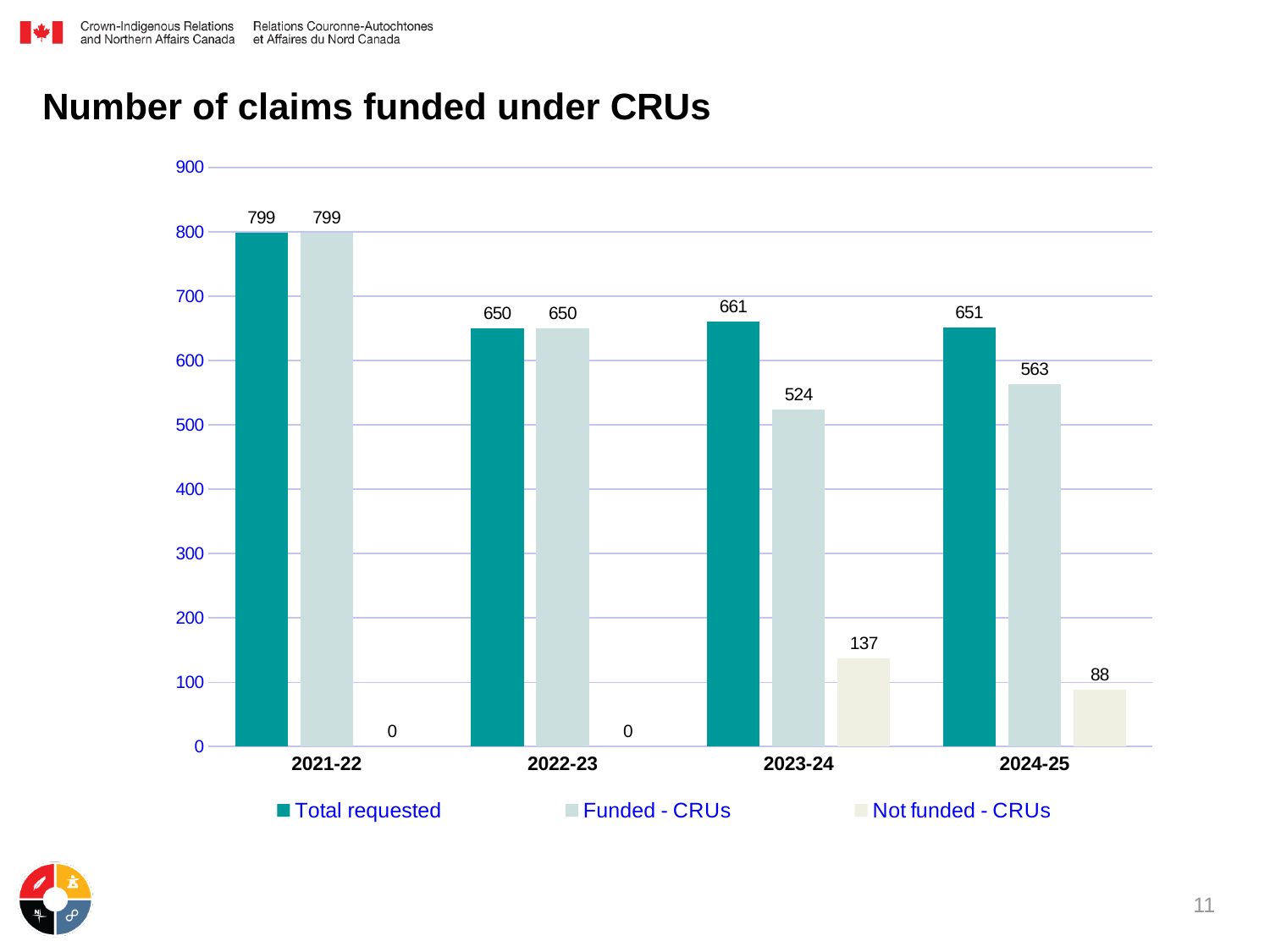
What kind of chart is shown on the slide? Bar chart What is the value for Not funded - CRUs in 2022-23? 0 What is the value for Not funded - CRUs in 2024-25? 88 What is the difference between Total requested and Funded - CRUs in 2024-25? 88 Which year has the lowest Funded - CRUs value? 2023-24 What is the title of the chart? Number of claims funded under CRUs Which year has the highest Total requested value? 2021-22 How many series does the legend list? 3 Which is larger in 2023-24: Funded - CRUs or Not funded - CRUs? Funded - CRUs How many years are shown on the x axis? 4 What is the value for Funded - CRUs in 2023-24? 524 What is the value for Total requested in 2021-22? 799